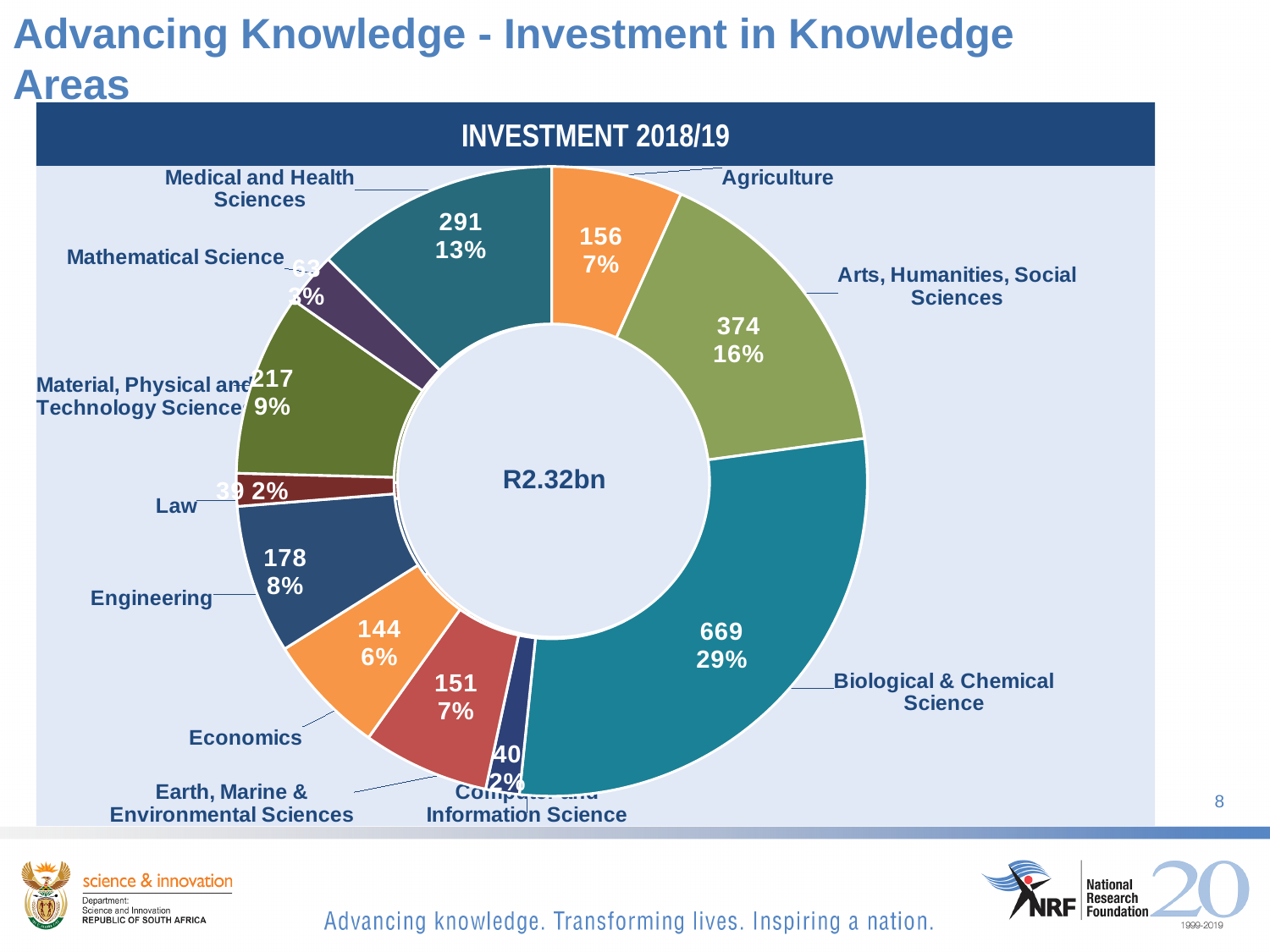
What share of the total does Arts, Humanities, Social Sciences represent? 16% What share of the total does Medical and Health Sciences represent? 13% What is the title of the chart? INVESTMENT 2018/19 Which is larger, the value for Economics or the value for Earth, Marine & Environmental Sciences? Earth, Marine & Environmental Sciences Which knowledge area has the largest investment? Biological & Chemical Science What is the value shown for Material, Physical and Technology Science? 217 What total is shown in the centre of the chart? R2.32bn What is the difference between the values for Medical and Health Sciences and Agriculture? 135 What is the value shown for Biological & Chemical Science? 669 What kind of chart is shown on the slide? doughnut chart How many knowledge areas are shown in the chart? 11 What is the value shown for Engineering? 178